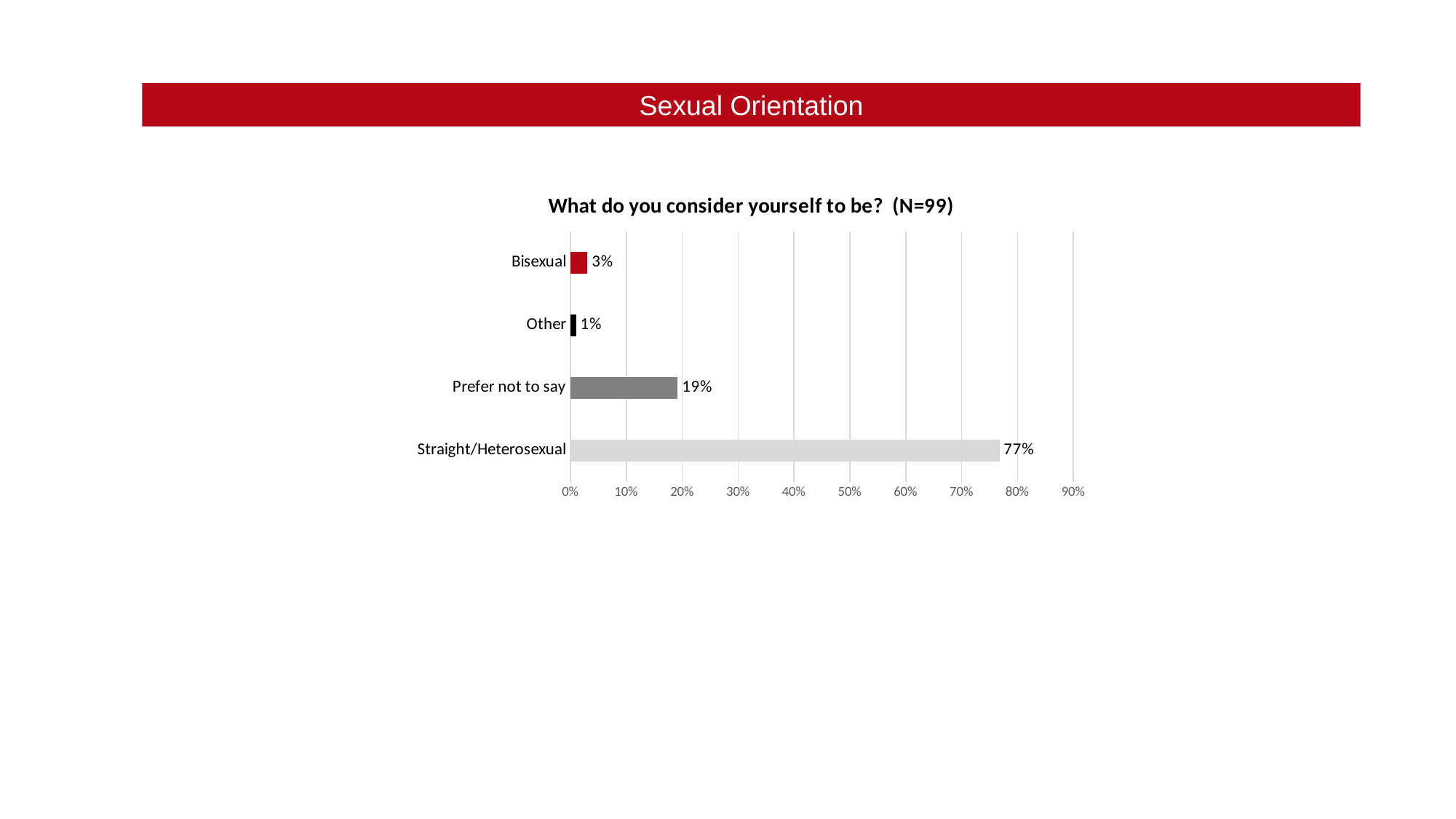
What percentage of respondents answered Bisexual? 3% Which category has the lowest percentage? Other What percentage of respondents answered Straight/Heterosexual? 77% How many categories are shown in the chart? 4 What percentage of respondents answered Prefer not to say? 19% What is the difference in percentage points between Straight/Heterosexual and Prefer not to say? 58 Is the value for Prefer not to say greater or less than 10%? greater What kind of chart is shown on the slide? Bar chart What is the title of the chart? What do you consider yourself to be? (N=99) Which category has the highest percentage? Straight/Heterosexual What percentage of respondents answered Other? 1% Which is larger, the value for Bisexual or the value for Other? Bisexual